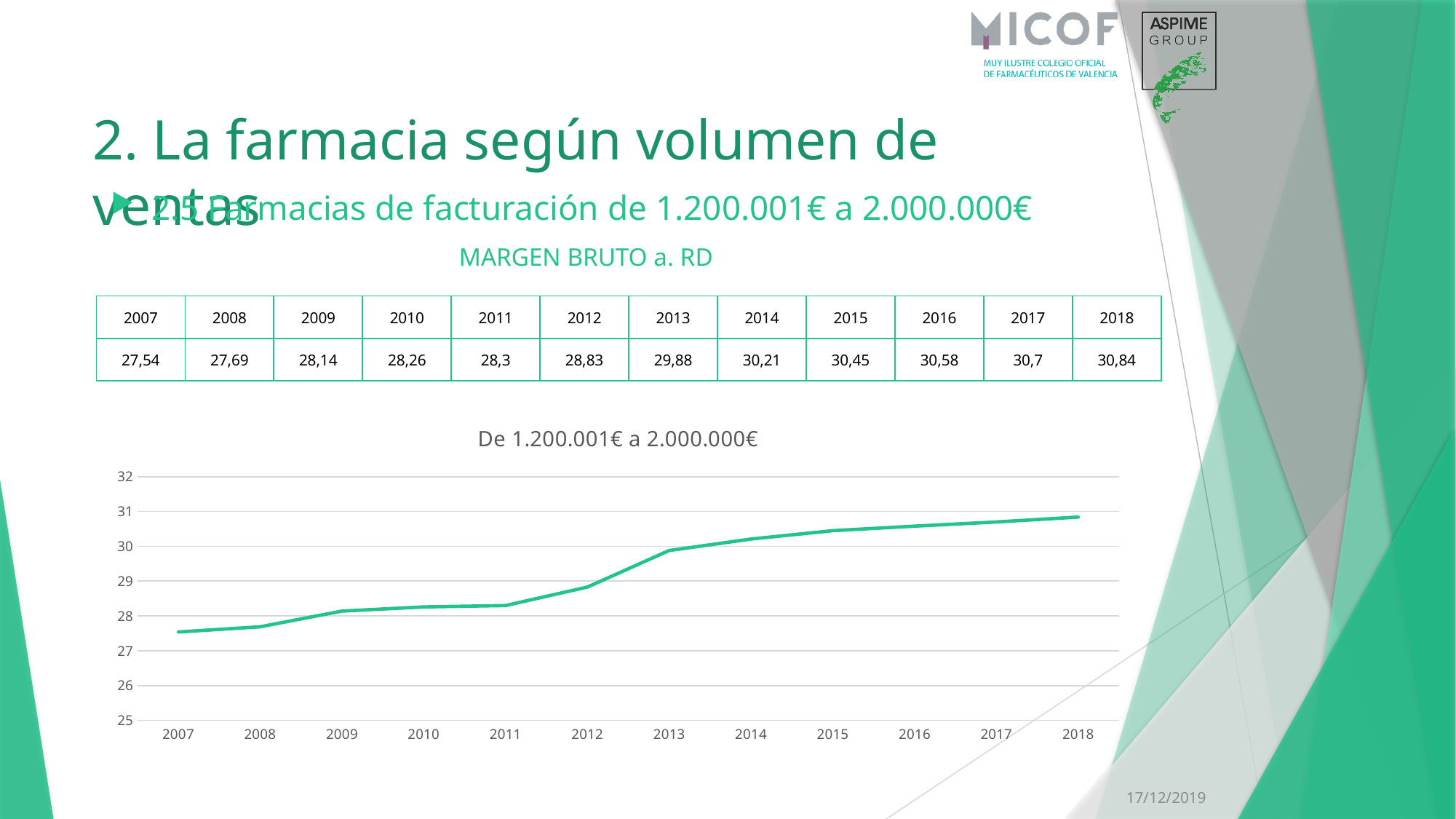
According to the table above the chart, what is the value for 2018? 30,84 According to the table above the chart, what is the value for 2013? 29,88 Do the values rise or fall from 2007 to 2018? rise Which year has the highest value in the chart? 2018 How many years are plotted along the x axis of the chart? 12 What kind of chart is shown on the slide? line chart Is the value for 2009 greater or less than 29? less Which year has the lowest value in the chart? 2007 According to the table above the chart, what is the value for 2007? 27,54 What is the title of the chart? De 1.200.001€ a 2.000.000€ Using the table values, what is the difference between the values for 2018 and 2007? 3,3 Is the value for 2013 greater or less than 29? greater